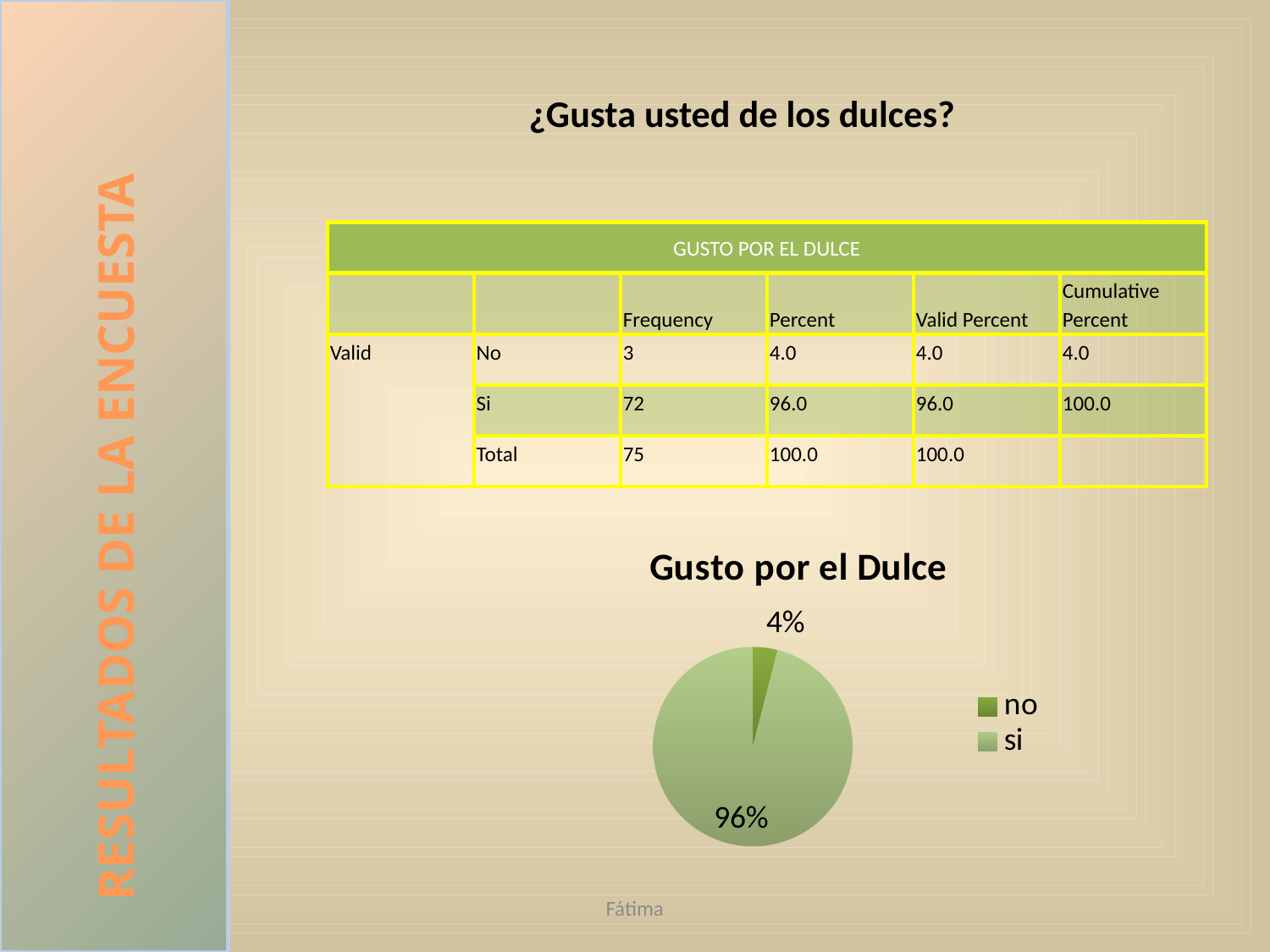
What is the title of the chart? Gusto por el Dulce Which legend entry is shown in the darker green colour? no What share of the pie does the "no" slice represent? 4% How many categories does the pie chart show? 2 Which slice is larger, "si" or "no"? si How many entries does the legend list? 2 Which category has the largest slice of the pie? si What is the difference in percentage points between the "si" and "no" slices? 92 What kind of chart is shown on the slide? pie chart What share of the pie does the "si" slice represent? 96% Which category has the smallest slice of the pie? no